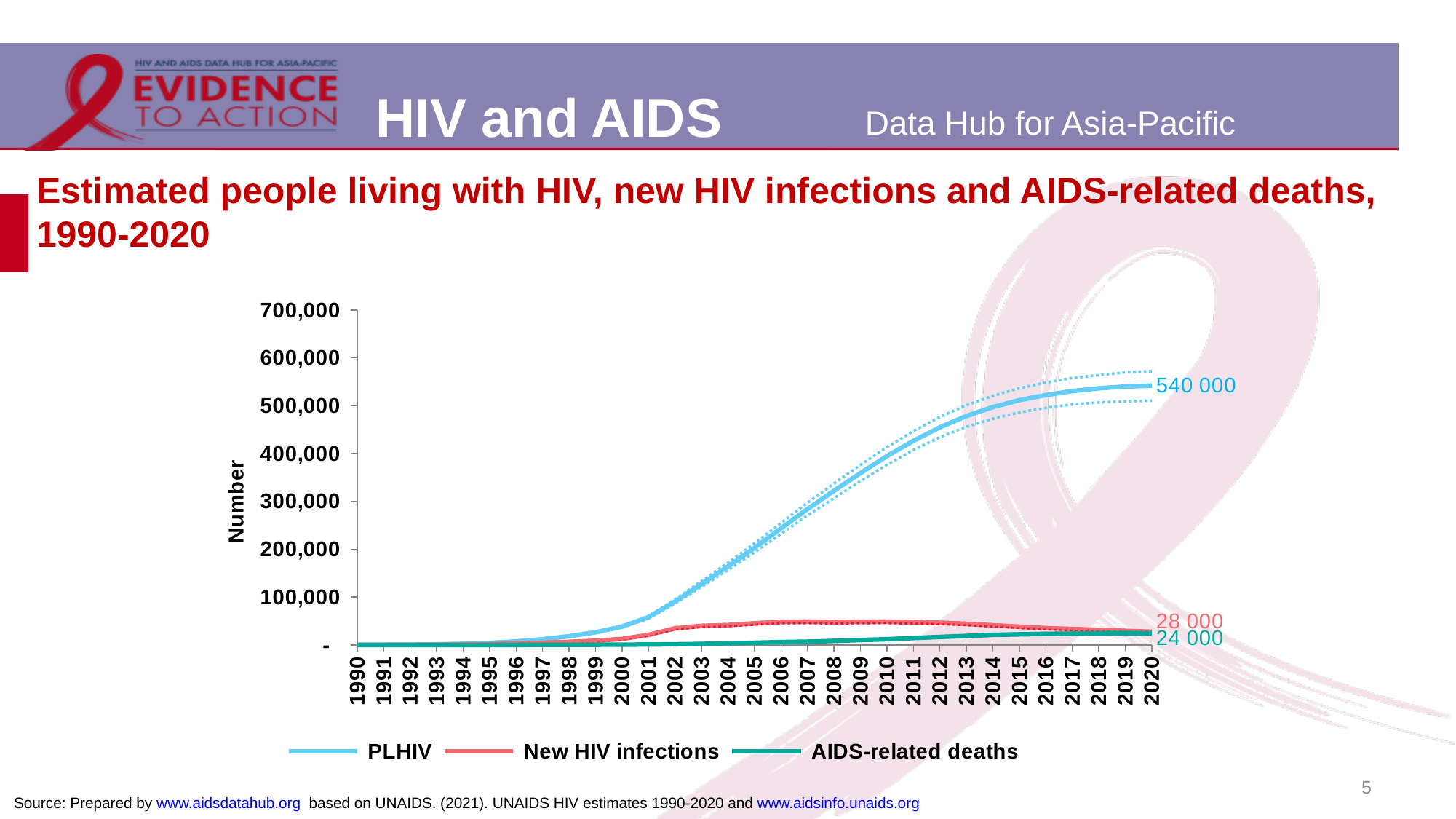
Which series has the lowest value in 2020? AIDS-related deaths What is the labelled value for AIDS-related deaths in 2020? 24 000 How many series does the legend list? 3 In 2020, which is larger: PLHIV or New HIV infections? PLHIV Is the value for PLHIV in 2005 greater or less than 300,000? less Is the value for PLHIV in 2015 greater or less than 400,000? greater What is the labelled value for PLHIV in 2020? 540 000 What kind of chart is shown on the slide? Line chart Which series has the highest value in 2020? PLHIV What is the difference between the 2020 values for New HIV infections and AIDS-related deaths? 4 000 What is the title of the vertical axis? Number What is the labelled value for New HIV infections in 2020? 28 000